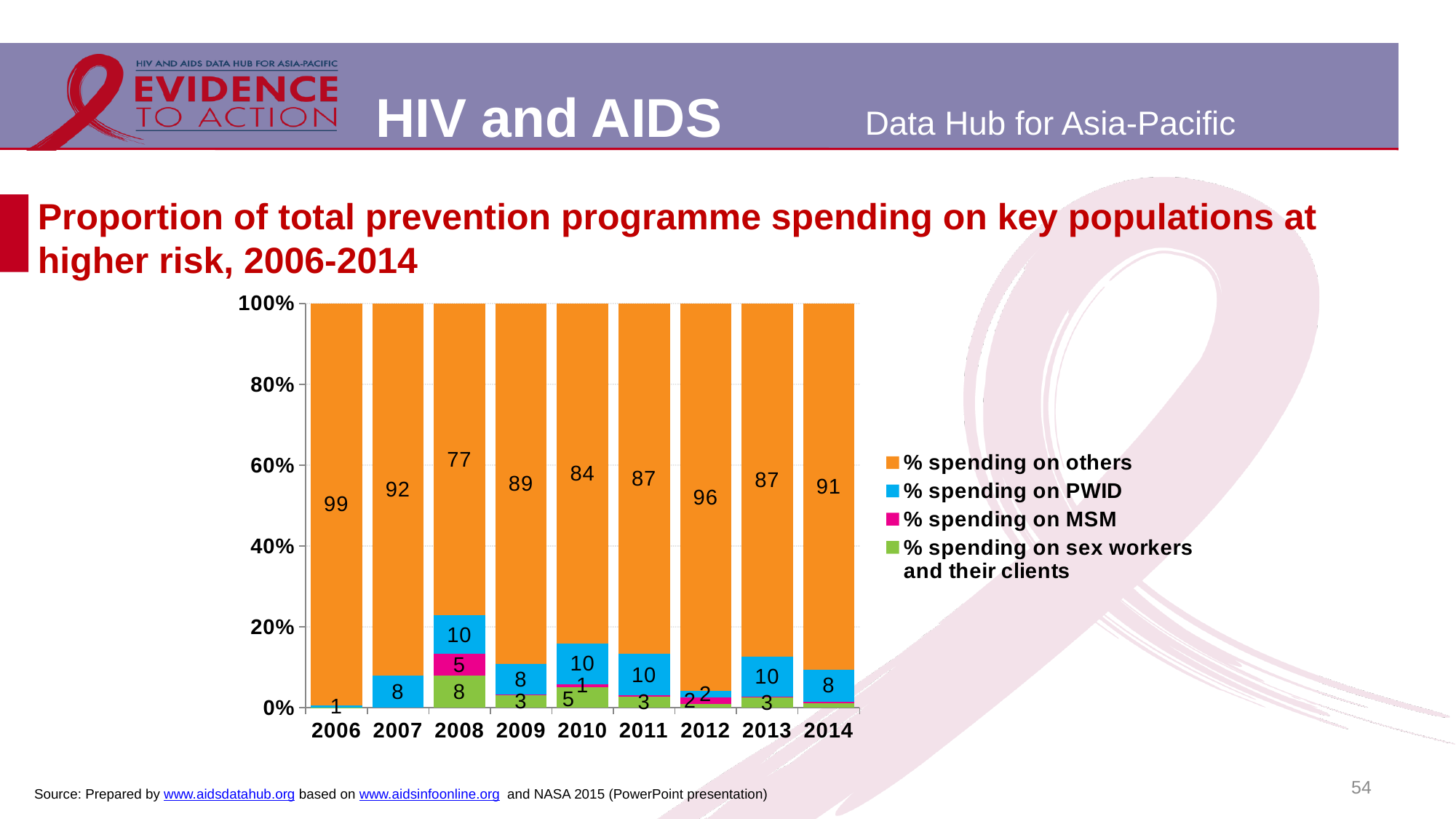
How many series does the legend list? 4 What is the value for % spending on others in 2008? 77 What is the value for % spending on PWID in 2013? 10 What kind of chart is shown on the slide? Stacked bar chart Which is larger, % spending on PWID in 2011 or in 2012? 2011 What is the difference between % spending on others in 2012 and in 2010? 12 In which year is % spending on others the lowest? 2008 Which colour represents % spending on MSM in the chart? Pink What is the value for % spending on MSM in 2008? 5 What is the value for % spending on sex workers and their clients in 2010? 5 In which year is % spending on others the highest? 2006 How many years are shown on the x axis? 9